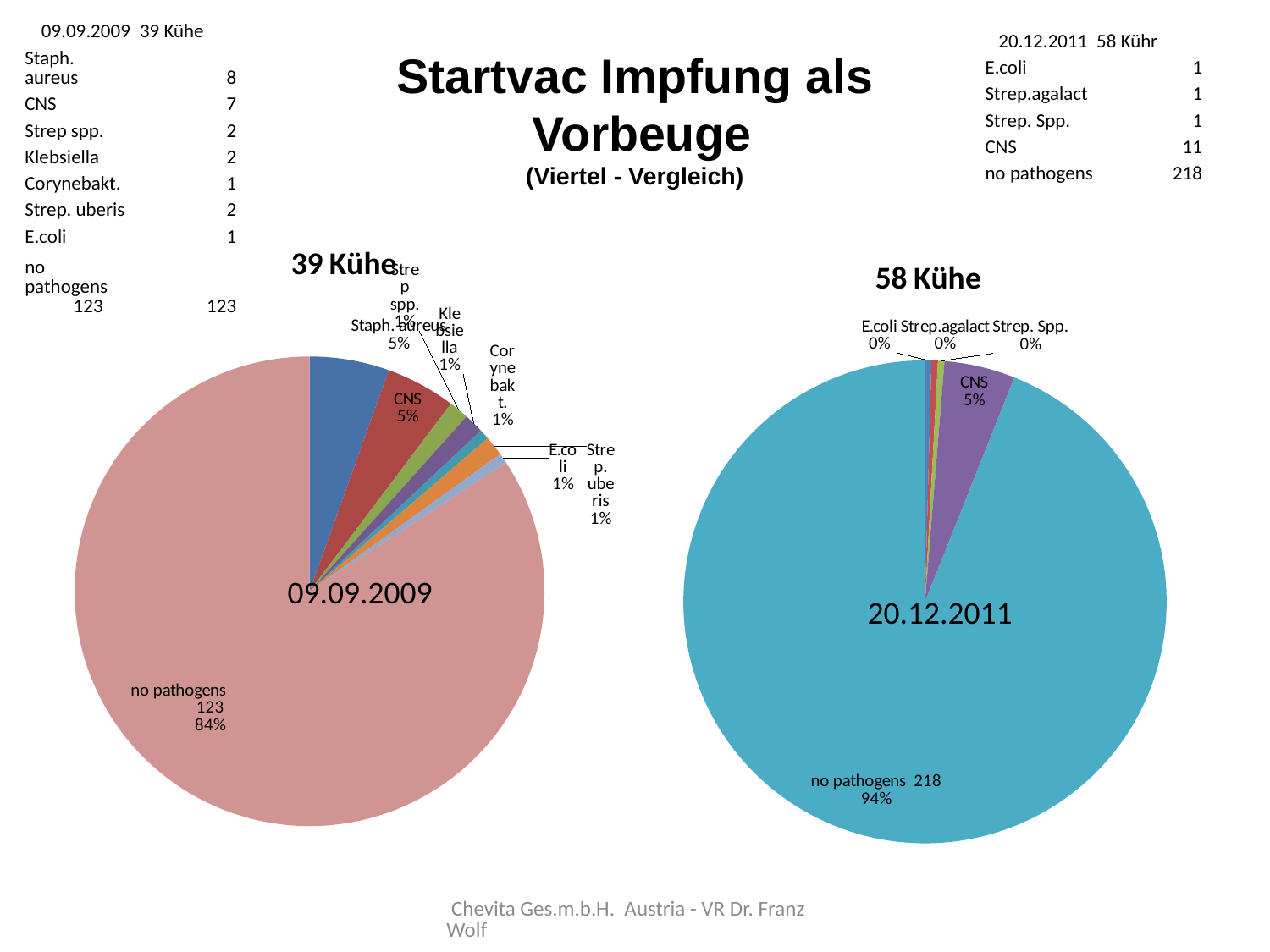
In the "58 Kühe" pie chart, what share is labelled for "no pathogens"? 94% In the "58 Kühe" pie chart, which category has the largest slice? no pathogens In the "39 Kühe" pie chart, what percentage is labelled for Staph. aureus? 5% How many slices does the "39 Kühe" pie chart have? 8 Which date is printed inside the "58 Kühe" pie chart? 20.12.2011 In the "58 Kühe" pie chart, what percentage is labelled for CNS? 5% What kind of chart is the "58 Kühe" chart? pie chart In the "39 Kühe" pie chart, what value is printed for "no pathogens"? 123 In the "39 Kühe" pie chart, which category has the largest slice? no pathogens In the "58 Kühe" pie chart, what value is printed for "no pathogens"? 218 How many slices does the "58 Kühe" pie chart have? 5